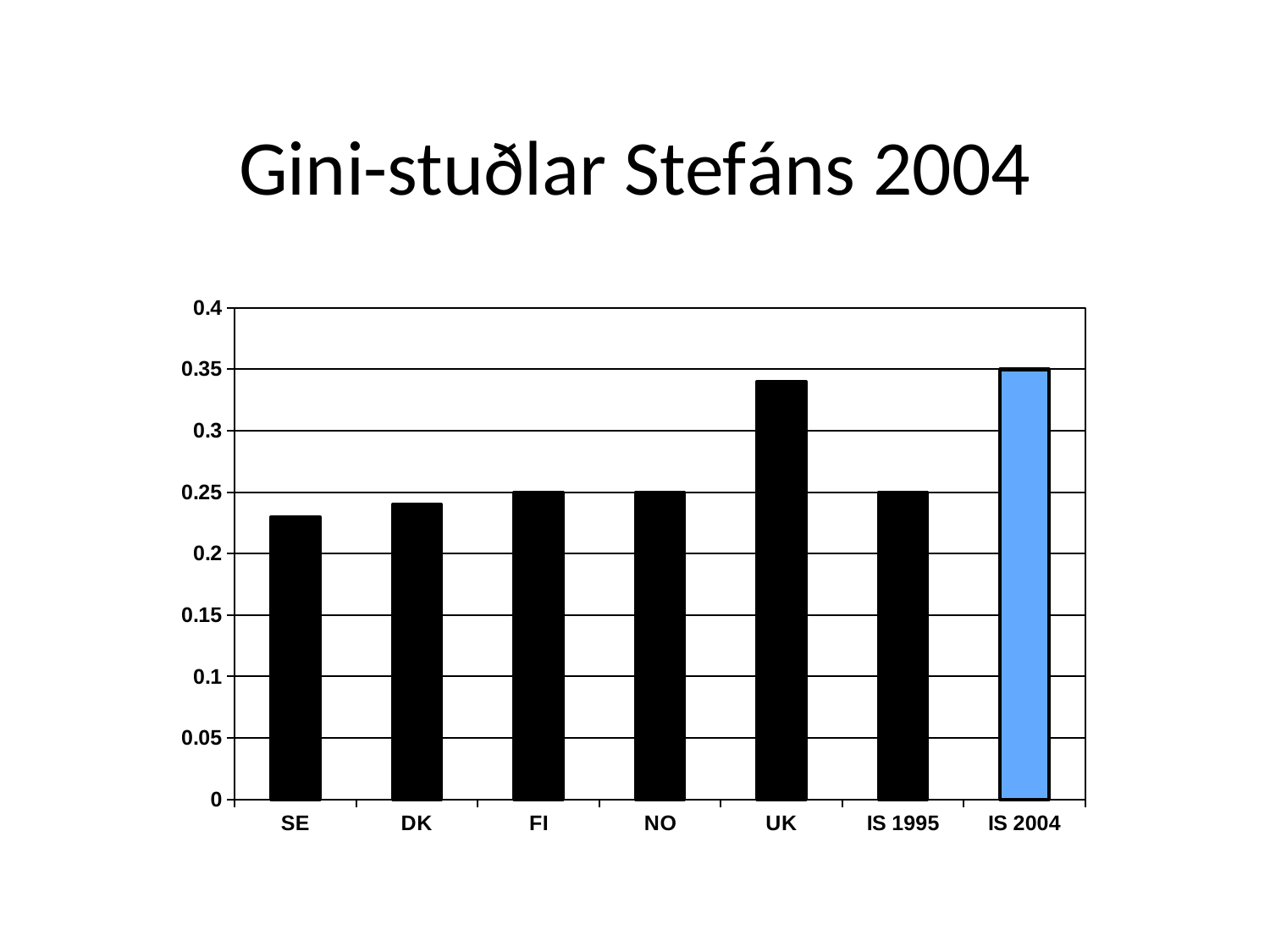
Which bar is coloured differently from the others? IS 2004 Is the value for SE greater or less than 0.25? less Which category has the lowest value? SE How many categories are shown on the x axis? 7 Which is larger, the value for UK or the value for NO? UK Which category has the highest value? IS 2004 Is the value for UK greater or less than 0.3? greater What is the title of the chart? Gini-stuðlar Stefáns 2004 What kind of chart is shown on the slide? bar chart Is the value for DK greater or less than 0.25? less What is the value for IS 2004? 0.35 What is the value for FI? 0.25